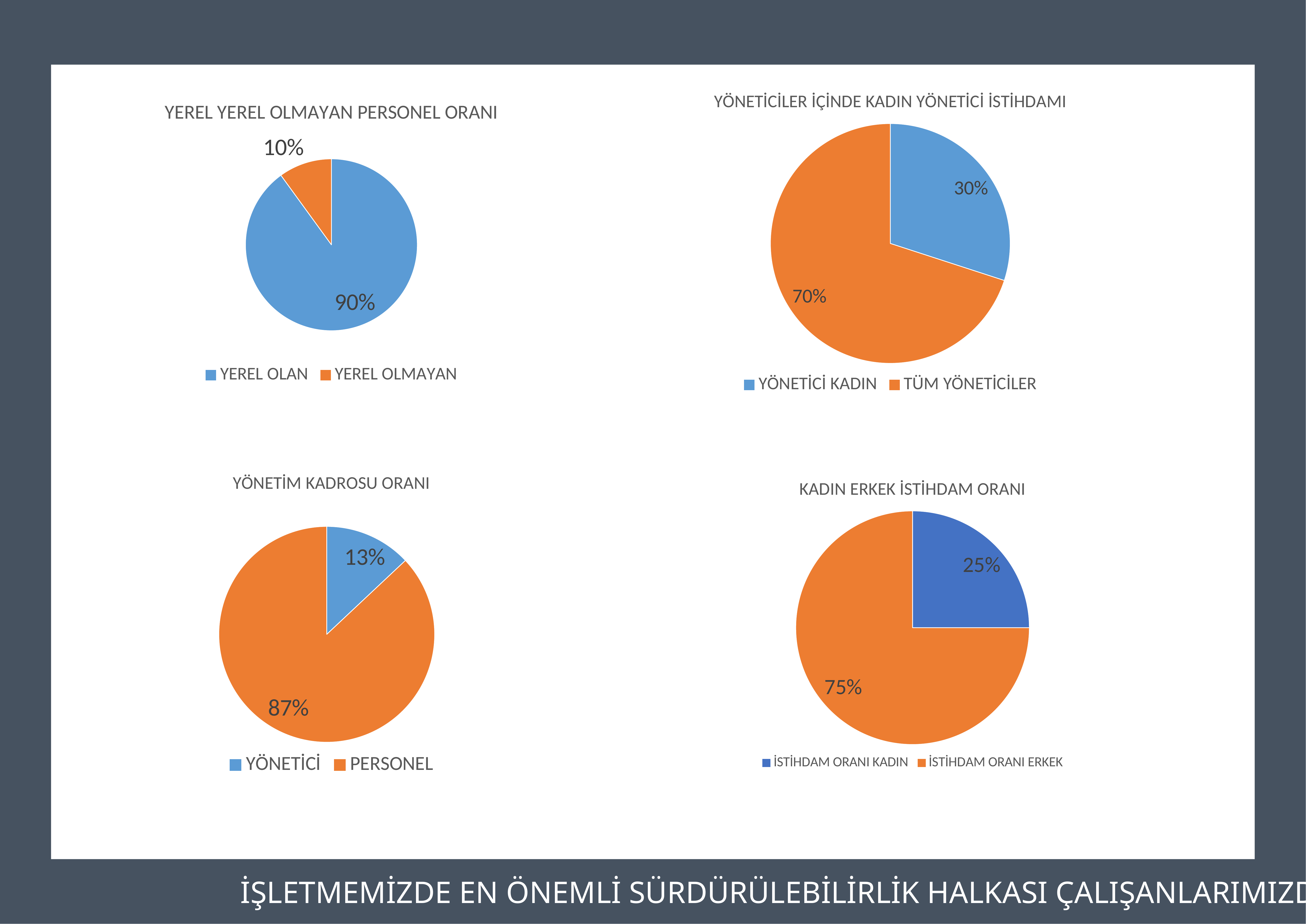
In the 'YEREL YEREL OLMAYAN PERSONEL ORANI' chart, what is the value for YEREL OLMAYAN? 10% What kind of chart is the 'YÖNETİM KADROSU ORANI' chart? Pie chart In the 'YÖNETİM KADROSU ORANI' chart, what is the difference between PERSONEL and YÖNETİCİ? 74% In the 'YÖNETİCİLER İÇİNDE KADIN YÖNETİCİ İSTİHDAMI' chart, which slice is the largest? TÜM YÖNETİCİLER In the 'YÖNETİM KADROSU ORANI' chart, what is the value for YÖNETİCİ? 13% In the 'YEREL YEREL OLMAYAN PERSONEL ORANI' chart, what share of the pie is YEREL OLAN? 90% How many slices does the 'YEREL YEREL OLMAYAN PERSONEL ORANI' chart have? 2 In the 'KADIN ERKEK İSTİHDAM ORANI' chart, which slice is the smallest? İSTİHDAM ORANI KADIN In the 'KADIN ERKEK İSTİHDAM ORANI' chart, which is larger, İSTİHDAM ORANI KADIN or İSTİHDAM ORANI ERKEK? İSTİHDAM ORANI ERKEK In the 'YÖNETİCİLER İÇİNDE KADIN YÖNETİCİ İSTİHDAMI' chart, what is the value for YÖNETİCİ KADIN? 30% How many charts are shown on the slide? 4 In the 'KADIN ERKEK İSTİHDAM ORANI' chart, what is the value for İSTİHDAM ORANI ERKEK? 75%